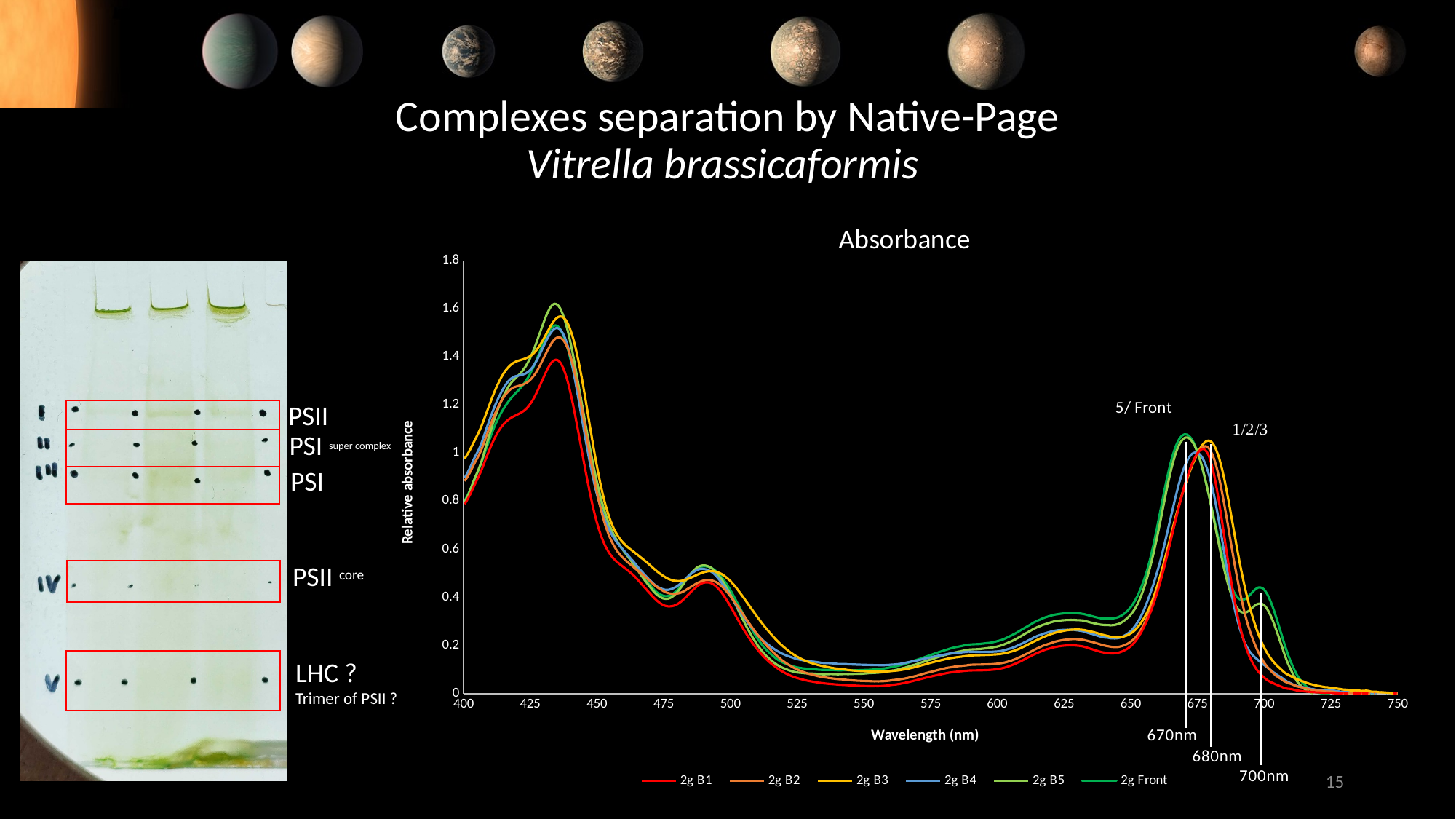
In the Absorbance chart, do the values rise or fall between 450 nm and 550 nm? fall In the Absorbance chart, is the value for 2g B1 at 600 nm greater or less than 0.4? less What kind of chart is the Absorbance chart? line chart What is the title of the chart on the slide? Absorbance In the Absorbance chart, which is larger for 2g B1: the value at 435 nm or the value at 550 nm? 435 nm In the Absorbance chart, is the value for 2g B1 at 550 nm greater or less than 0.2? less In the Absorbance chart, which series has the lowest peak near 435 nm? 2g B1 In the Absorbance chart, is the peak value of 2g B3 near 435 nm greater or less than 1.4? greater What is the label of the x axis of the Absorbance chart? Wavelength (nm) How many series does the legend of the Absorbance chart list? 6 In the Absorbance chart, which series has the highest peak near 435 nm? 2g B5